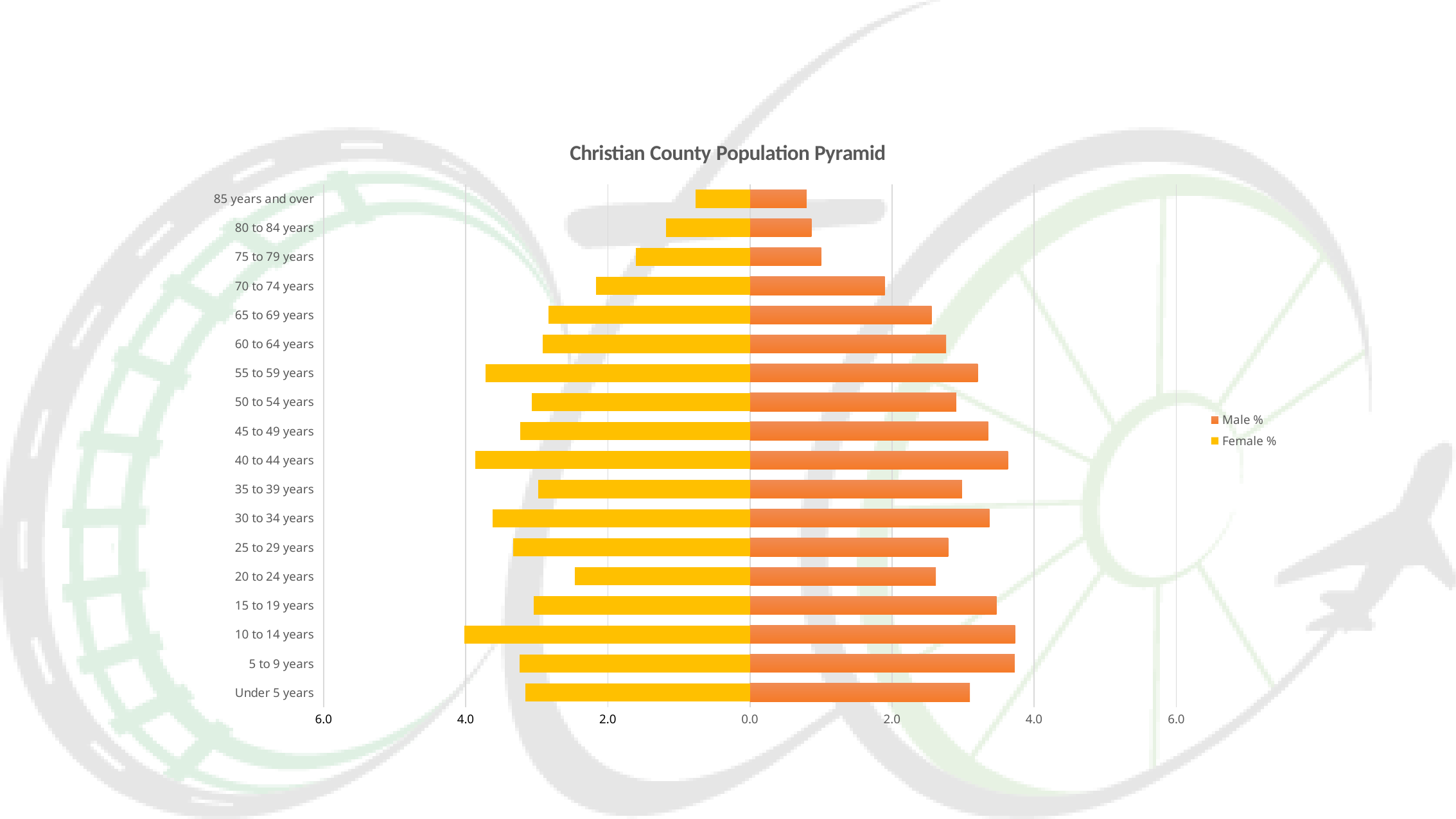
How many age-group categories are shown on the chart? 18 Is the Male % value for 10 to 14 years greater or less than 4.0? less Which is larger, the Female % value for 55 to 59 years or for 35 to 39 years? 55 to 59 years Which is larger, the Male % value for 40 to 44 years or for 20 to 24 years? 40 to 44 years Is the Male % value for 75 to 79 years greater or less than 2.0? less How many series does the legend list? 2 Is the Female % value for 20 to 24 years greater or less than 2.0? greater Which age group has the lowest Female % value? 85 years and over What is the title of the chart? Christian County Population Pyramid What kind of chart is shown on the slide? bar chart Which colour represents the Female % series? yellow